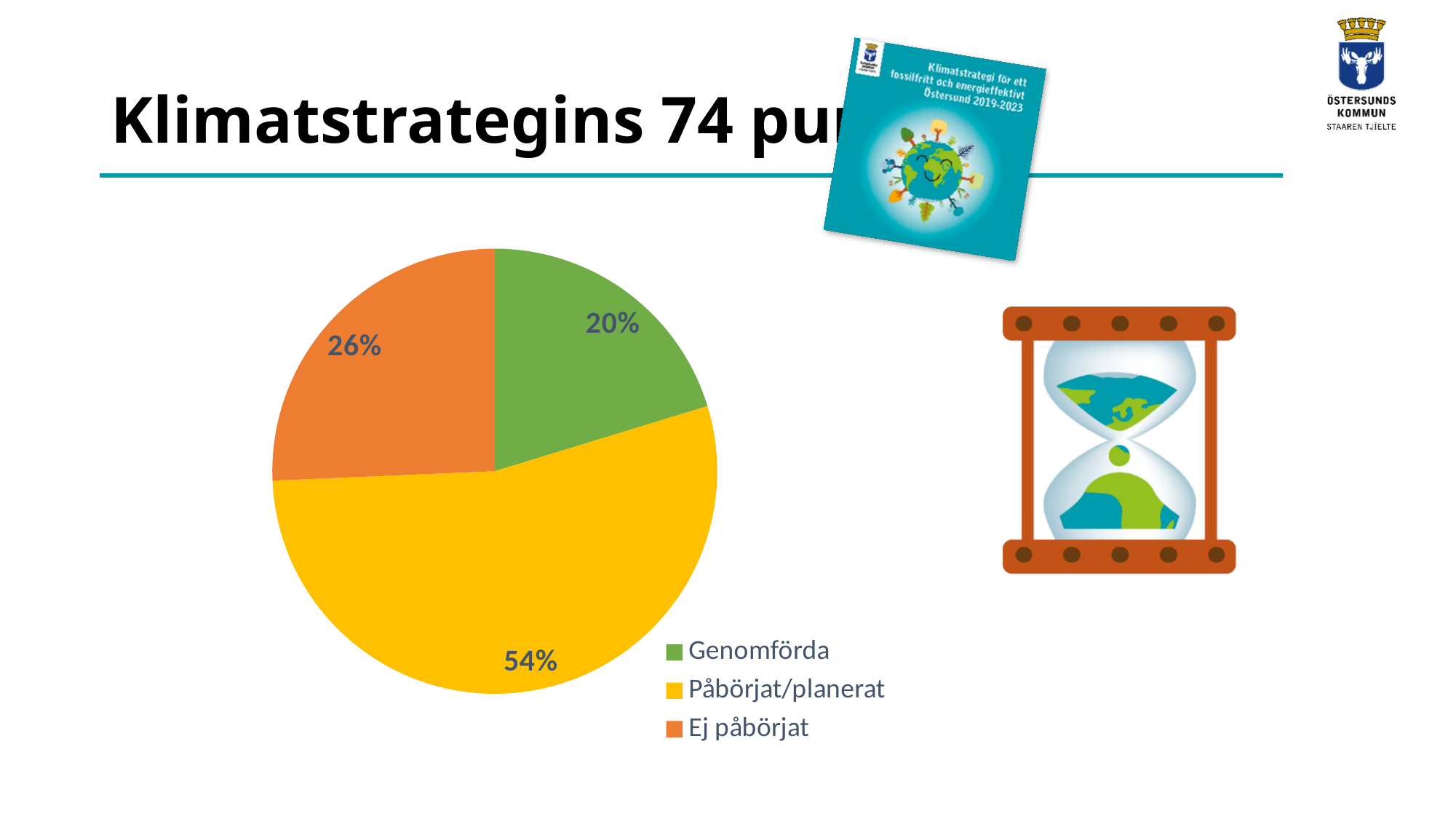
What share of the pie is Påbörjat/planerat? 54% What colour is the Påbörjat/planerat slice? yellow Which legend entry is shown in green? Genomförda Which is larger, the share for Ej påbörjat or the share for Genomförda? Ej påbörjat What kind of chart is shown on the slide? pie chart How many entries does the legend list? 3 What is the difference in percentage points between Påbörjat/planerat and Ej påbörjat? 28 What share of the pie is Genomförda? 20% How many slices does the pie chart have? 3 Which category has the smallest slice of the pie? Genomförda Which category has the largest slice of the pie? Påbörjat/planerat What share of the pie is Ej påbörjat? 26%